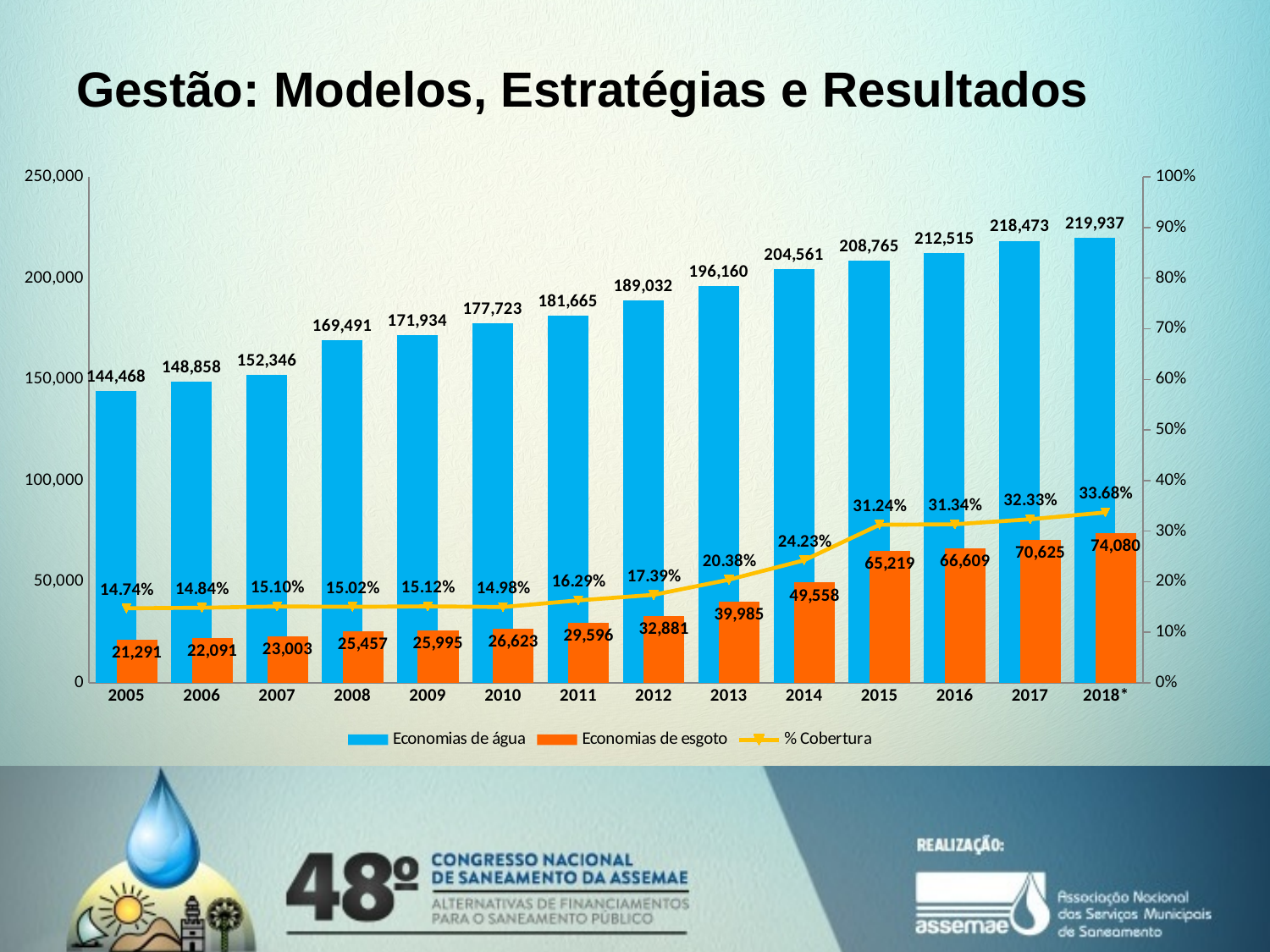
What is the difference between Economias de água in 2018* and in 2005? 75,469 How many series does the legend list? 3 What is the difference between Economias de esgoto in 2016 and in 2015? 1,390 Is the value of Economias de esgoto for 2017 greater or less than 50,000? greater What is the value of Economias de esgoto for 2014? 49,558 What is the % Cobertura value for 2013? 20.38% How many years are shown on the x axis? 14 What is the value of Economias de água for 2010? 177,723 In which year is Economias de água highest? 2018* In which year is Economias de esgoto lowest? 2005 Does Economias de água rise or fall from 2005 to 2018*? rise Which is larger, Economias de água in 2012 or in 2013? 2013